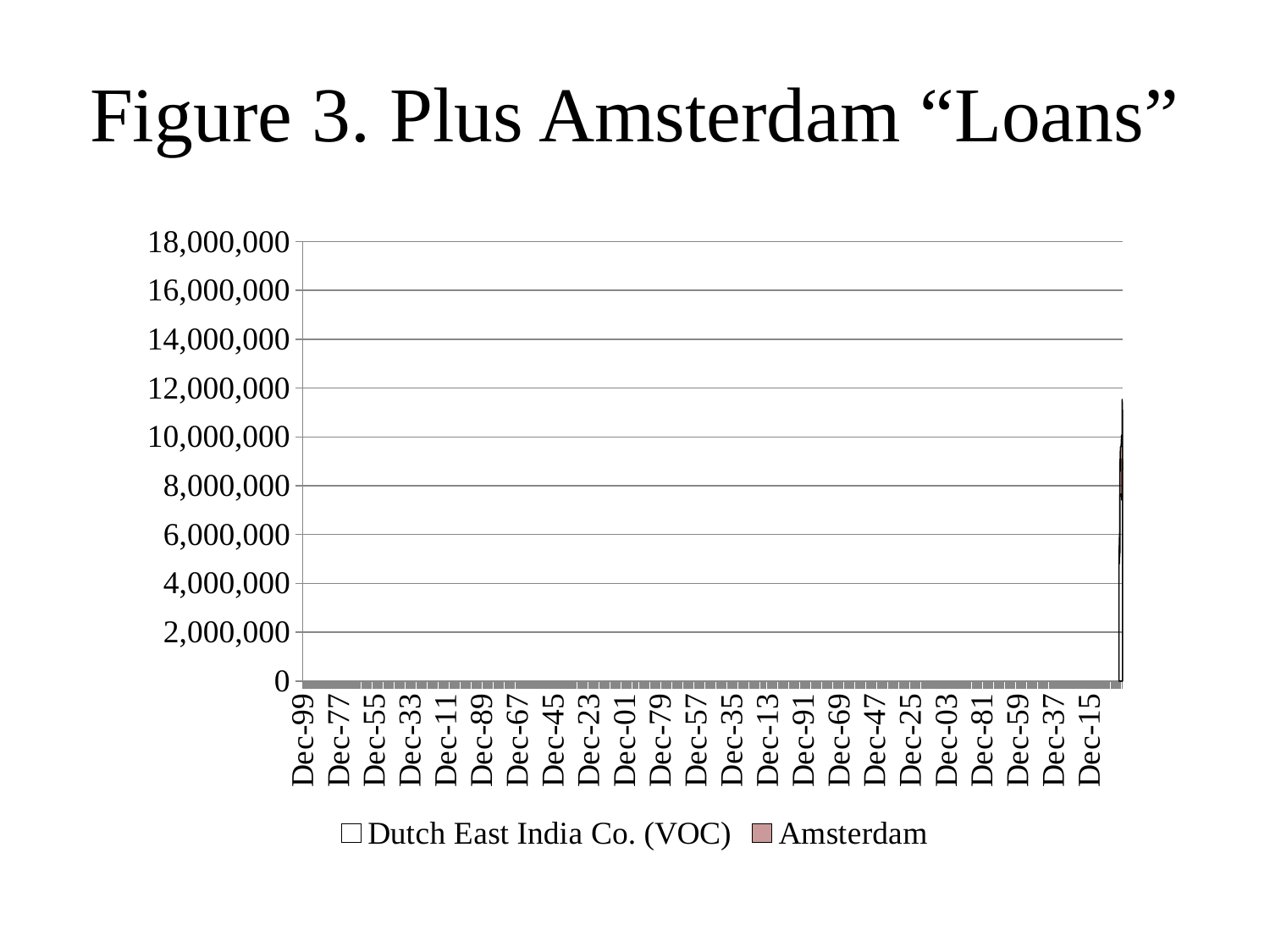
What is the highest value shown on the y axis? 18,000,000 What is the last x-axis label printed on the chart? Dec-15 Is the peak value reached at the far right of the chart greater or less than 12,000,000? less What is the title of the slide's chart? Figure 3. Plus Amsterdam "Loans" What is the first x-axis label on the chart? Dec-99 Which two series are listed in the legend? Dutch East India Co. (VOC) and Amsterdam What kind of chart is shown on the slide? Area chart How do the values behave along the x axis? Flat near zero, then a sharp spike at the far right How many series does the legend list? 2 How many x-axis labels are printed along the bottom of the chart? 23 Is the value at Dec-99, the first x-axis label, greater or less than 2,000,000? less Is the peak value reached at the far right of the chart greater or less than 10,000,000? greater